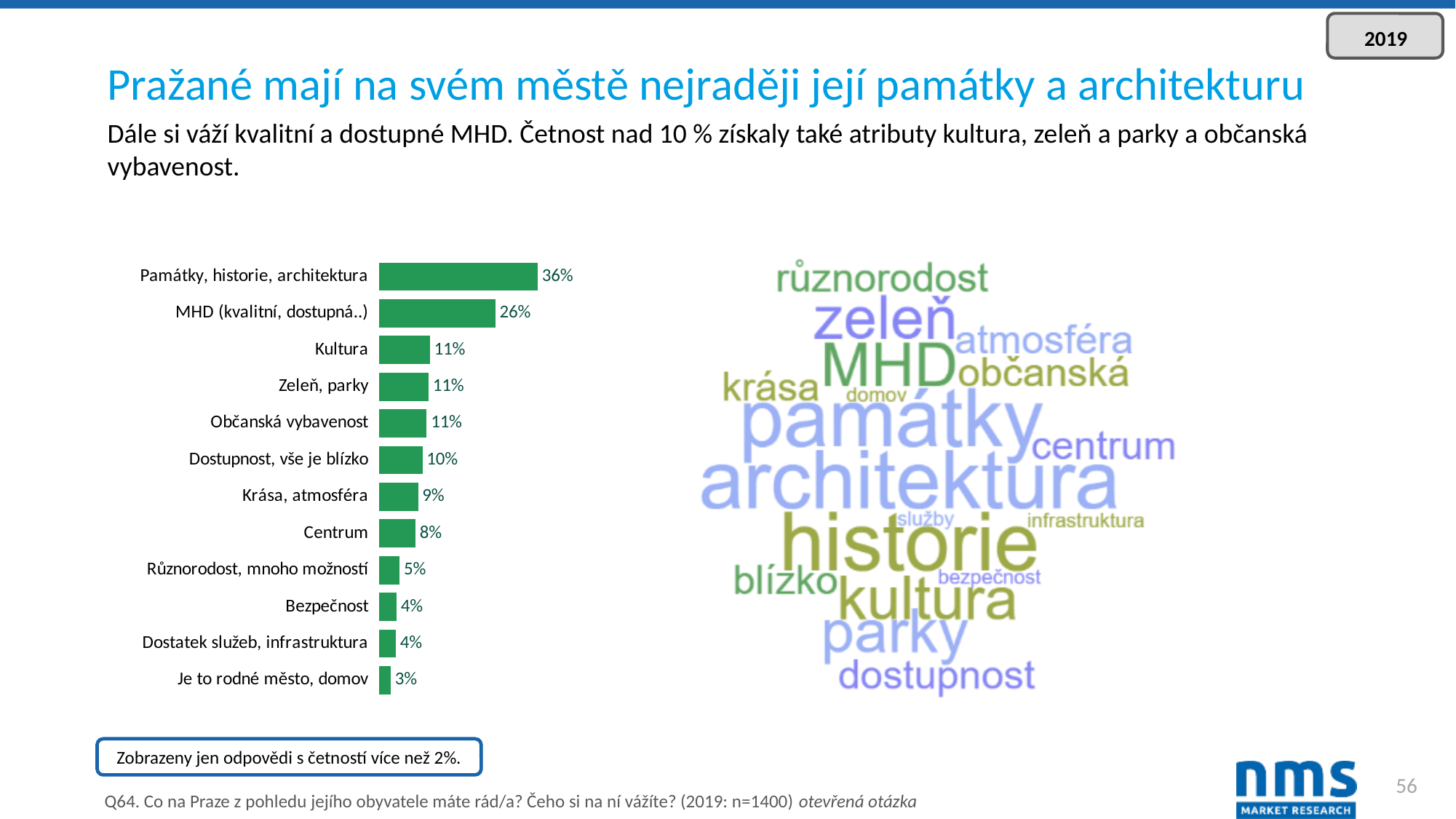
What kind of chart is shown on the left of the slide? Bar chart What is the value for Dostupnost, vše je blízko in the bar chart? 10% What is the value for MHD (kvalitní, dostupná..) in the bar chart? 26% Which category has the highest value in the bar chart? Památky, historie, architektura What colour are the bars in the bar chart? Green What is the difference between the values for Kultura and Bezpečnost in the bar chart? 7% Which category has the lowest value in the bar chart? Je to rodné město, domov How many categories are shown in the bar chart? 12 Which is larger in the bar chart: Krása, atmosféra or Centrum? Krása, atmosféra What is the value for Centrum in the bar chart? 8% What is the difference between the values for Památky, historie, architektura and MHD (kvalitní, dostupná..)? 10% What is the value for Památky, historie, architektura in the bar chart? 36%